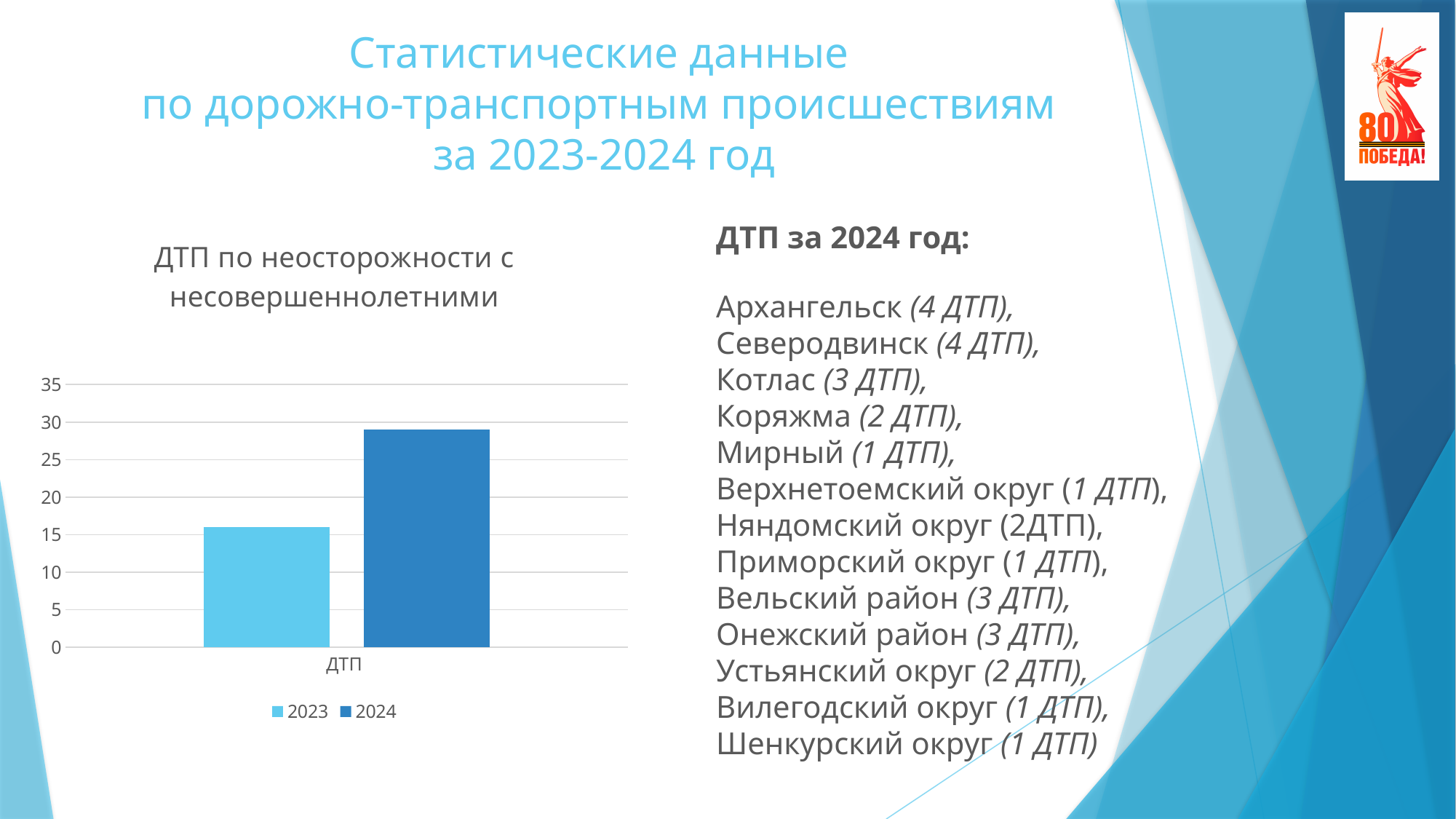
Which series has the lowest bar in the chart? 2023 Is the value for 2024 greater or less than 35? less Is the value for 2023 greater or less than 10? greater How many series does the chart's legend list? 2 Is the value for 2023 greater or less than 20? less How many categories are shown on the x axis of the chart? 1 What is the title of the chart on the slide? ДТП по неосторожности с несовершеннолетними What is the label of the category on the x axis of the chart? ДТП Which series are listed in the chart's legend? 2023 and 2024 What kind of chart is shown on the slide? bar chart Which series has the higher bar in the chart, 2023 or 2024? 2024